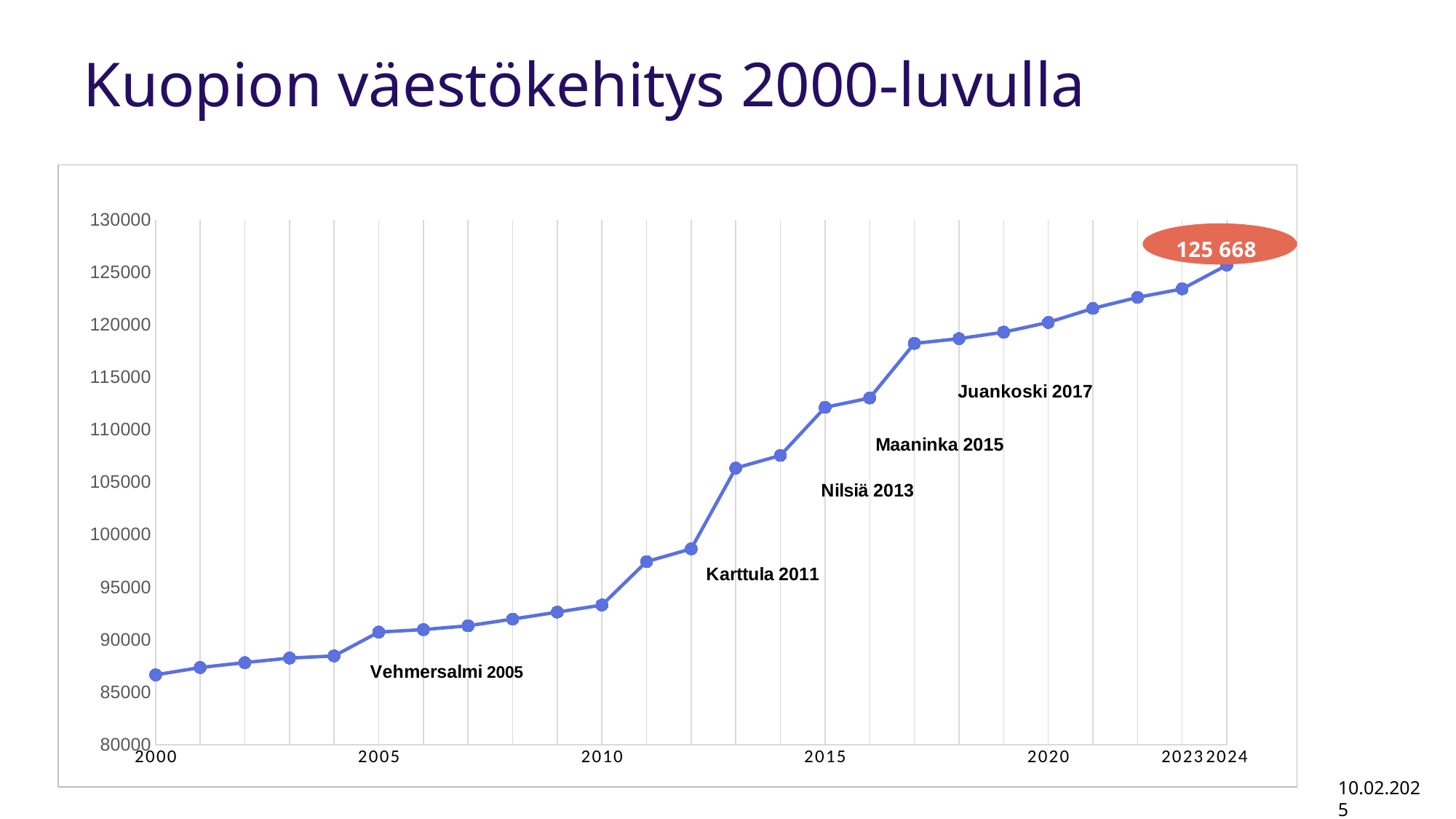
Is the value for 2010 greater or less than 95000? less Is the value for 2000 greater or less than 90000? less Is the value for 2017 greater or less than 120000? less Which municipality is annotated on the chart at 2011? Karttula How many data points are plotted on the line? 25 Do the values generally rise or fall from 2000 to 2024? rise Which year has the larger value, 2012 or 2015? 2015 Which year has the highest population value? 2024 What type of chart is shown on the slide? line chart What is the population value printed for 2024? 125 668 Which year has the lowest population value? 2000